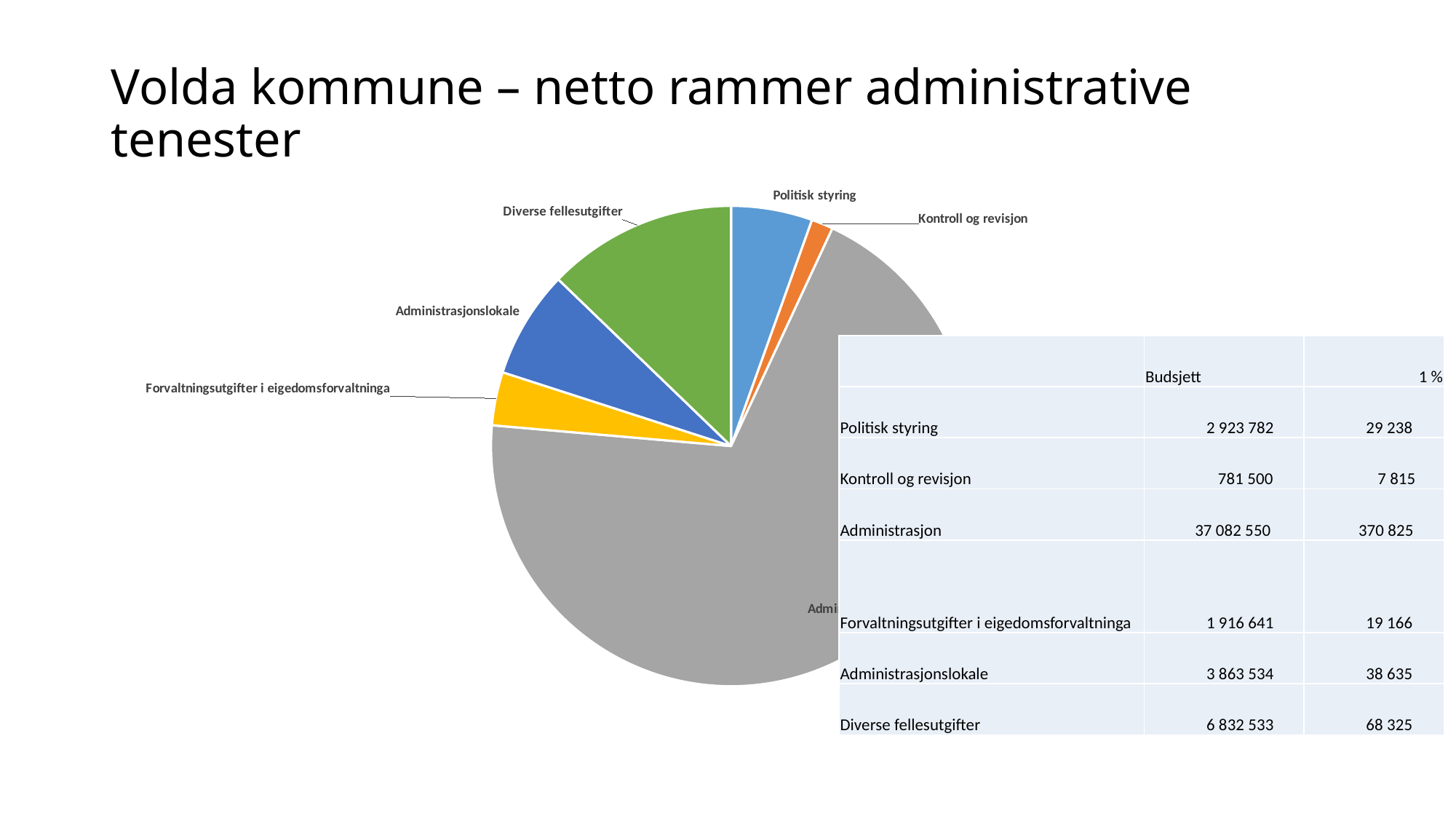
According to the table on the slide, what is the Budsjett value for Diverse fellesutgifter? 6 832 533 What colour is the Diverse fellesutgifter slice in the pie chart? Green Which slice is larger, Diverse fellesutgifter or Administrasjonslokale? Diverse fellesutgifter What kind of chart is shown on the slide? Pie chart Which category has the smallest slice in the pie chart? Kontroll og revisjon Using the Budsjett values in the table, what is the difference between Politisk styring and Kontroll og revisjon? 2 142 282 According to the table on the slide, what is the Budsjett value for Administrasjon? 37 082 550 How many slices does the pie chart have? 6 Which slice is larger, Forvaltningsutgifter i eigedomsforvaltninga or Administrasjonslokale? Administrasjonslokale Which slice is larger, Politisk styring or Kontroll og revisjon? Politisk styring Which category has the largest slice in the pie chart? Administrasjon According to the table on the slide, what is the Budsjett value for Politisk styring? 2 923 782